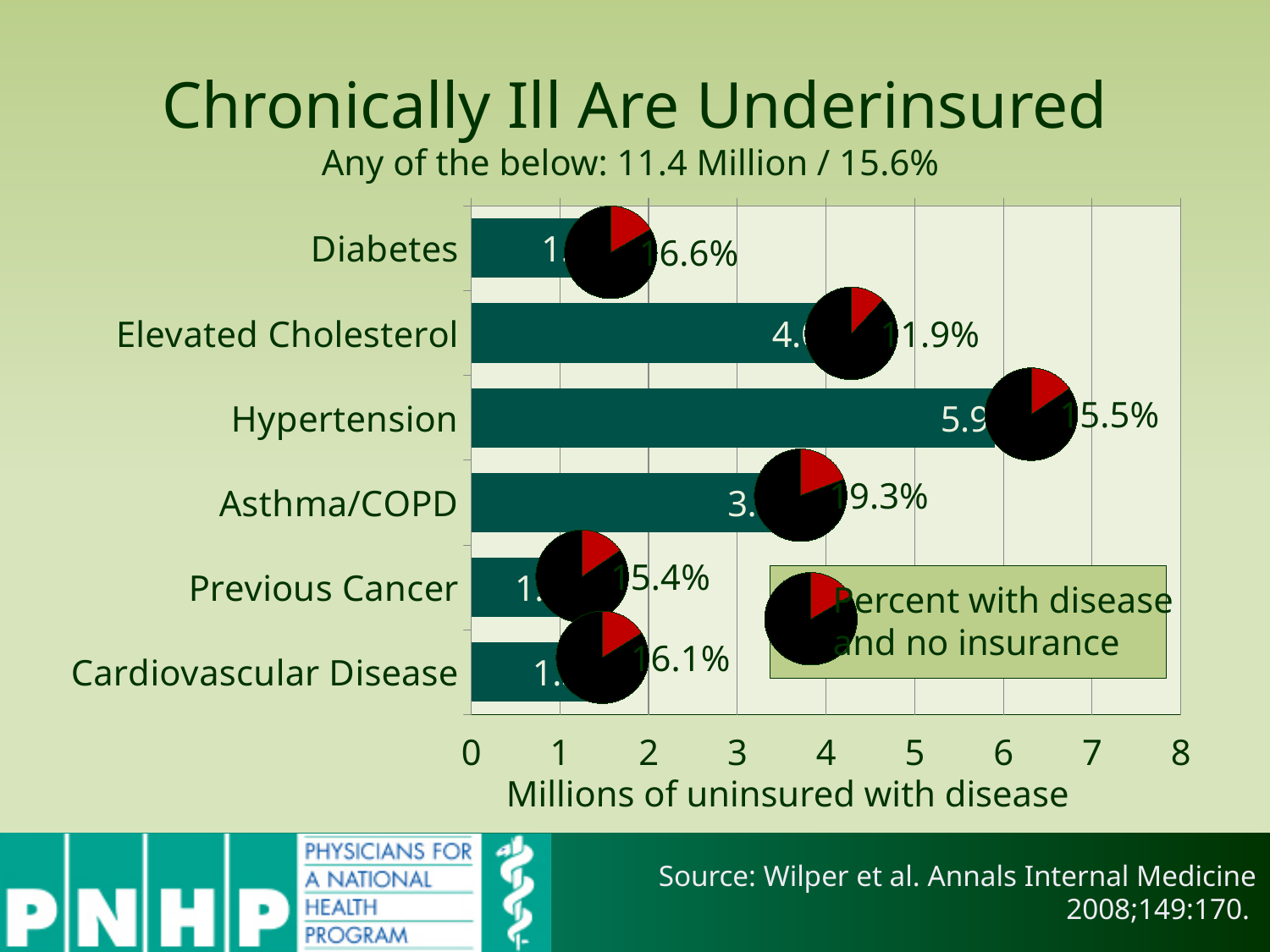
How many disease categories are plotted in the chart? 6 Which has more millions of uninsured with disease, Hypertension or Cardiovascular Disease? Hypertension What is the title of the horizontal axis of the chart? Millions of uninsured with disease Is the value for Hypertension greater or less than 5 million? greater What does the legend entry with the pie icon say? Percent with disease and no insurance Which disease category has the highest number of millions of uninsured with disease? Hypertension What is the value (millions of uninsured with disease) for Hypertension? 5.9 Is the value for Diabetes greater or less than 2 million? less Is the value for Asthma/COPD greater or less than 3 million? greater What kind of chart is shown on the slide? bar chart Which has more millions of uninsured with disease, Elevated Cholesterol or Asthma/COPD? Elevated Cholesterol